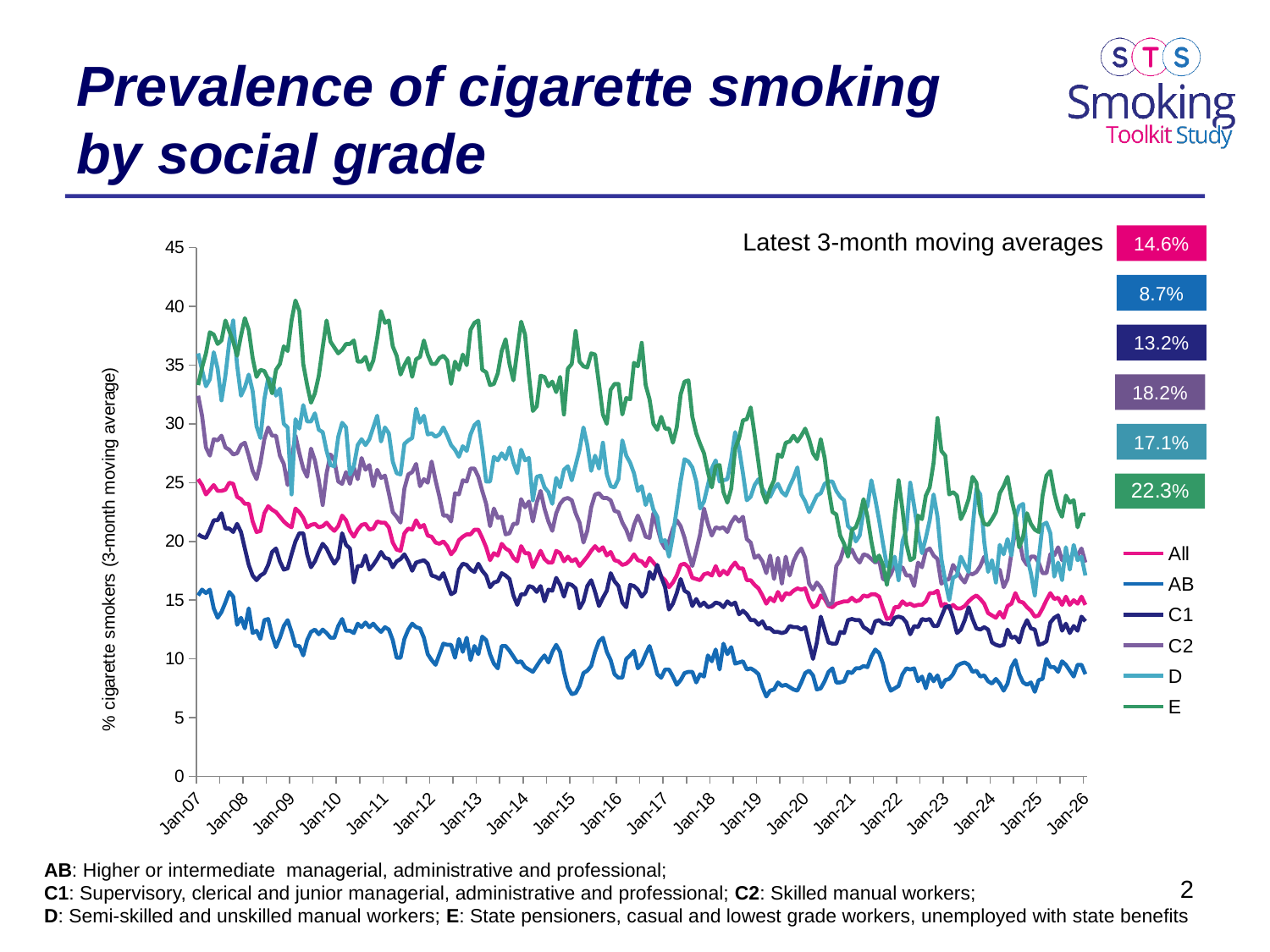
What is the latest 3-month moving average for social grade C2? 18.2% Which social grade has the lowest latest 3-month moving average? AB How many series does the legend list? 6 What is the latest 3-month moving average for social grade AB? 8.7% What is the latest 3-month moving average for social grade E? 22.3% What kind of chart is shown on the slide? line chart What is the difference between the latest 3-month moving averages for grade E and grade AB? 13.6% What is the label on the y axis of the chart? % cigarette smokers (3-month moving average) What is the latest 3-month moving average for the All series? 14.6% Which social grade has the highest latest 3-month moving average? E Which has a larger latest 3-month moving average, grade C2 or grade D? C2 Does the AB series generally rise or fall from Jan-07 to Jan-26? fall